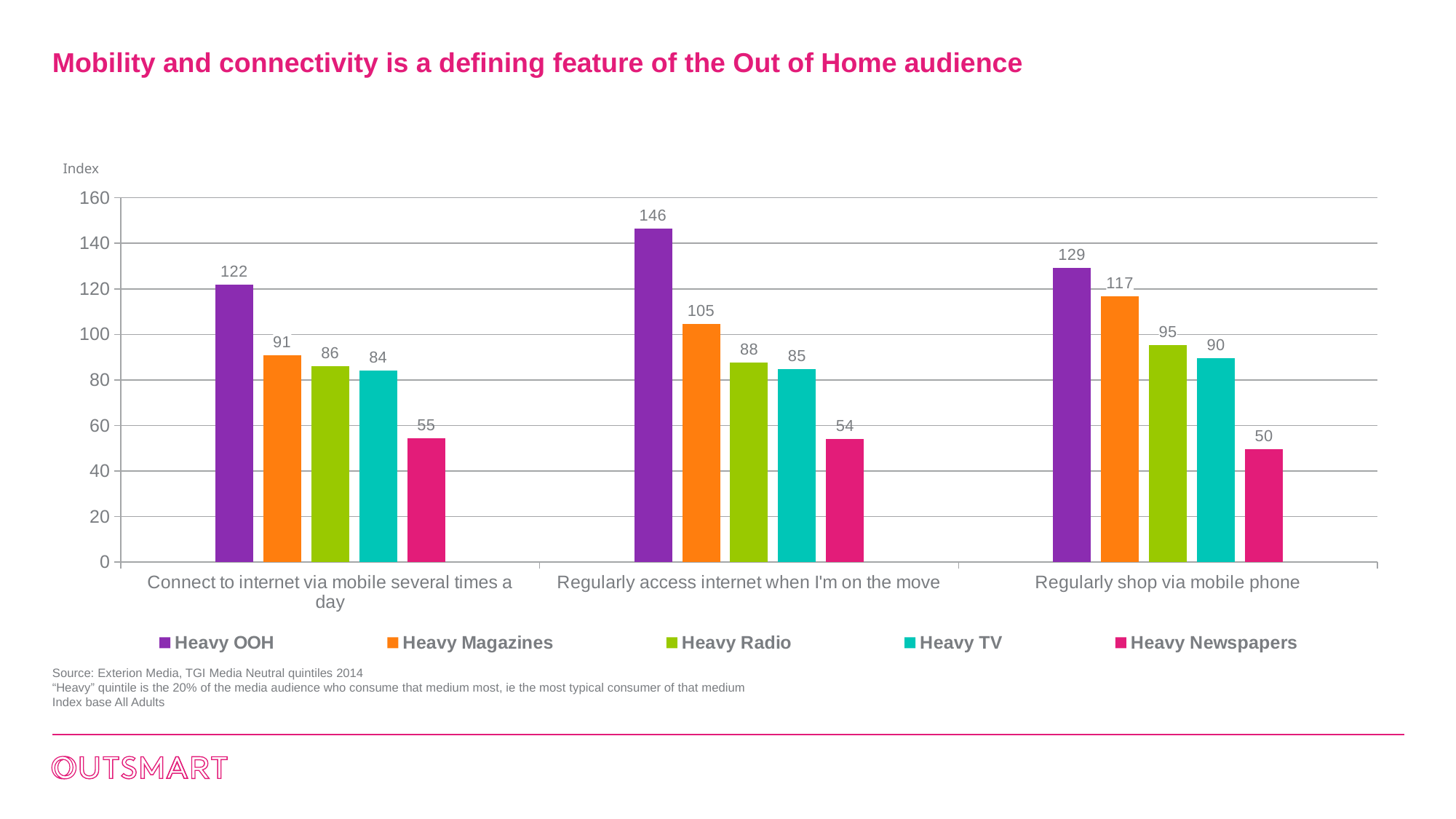
What is the Heavy OOH index for 'Regularly access internet when I'm on the move'? 146 Which series has the highest index for 'Regularly shop via mobile phone'? Heavy OOH What is the Heavy Newspapers index for 'Regularly shop via mobile phone'? 50 How many series does the legend list? 5 What is the Heavy Magazines index for 'Connect to internet via mobile several times a day'? 91 Which is larger for 'Regularly shop via mobile phone': the Heavy Radio index or the Heavy TV index? Heavy Radio Which series has the lowest index for 'Connect to internet via mobile several times a day'? Heavy Newspapers What colour are the Heavy TV bars? Teal What kind of chart is shown on the slide? Bar chart Is the Heavy OOH value for 'Connect to internet via mobile several times a day' greater or less than 100? greater What is the difference between the Heavy OOH and Heavy Magazines indices for 'Regularly access internet when I'm on the move'? 41 How many categories are shown on the x axis? 3